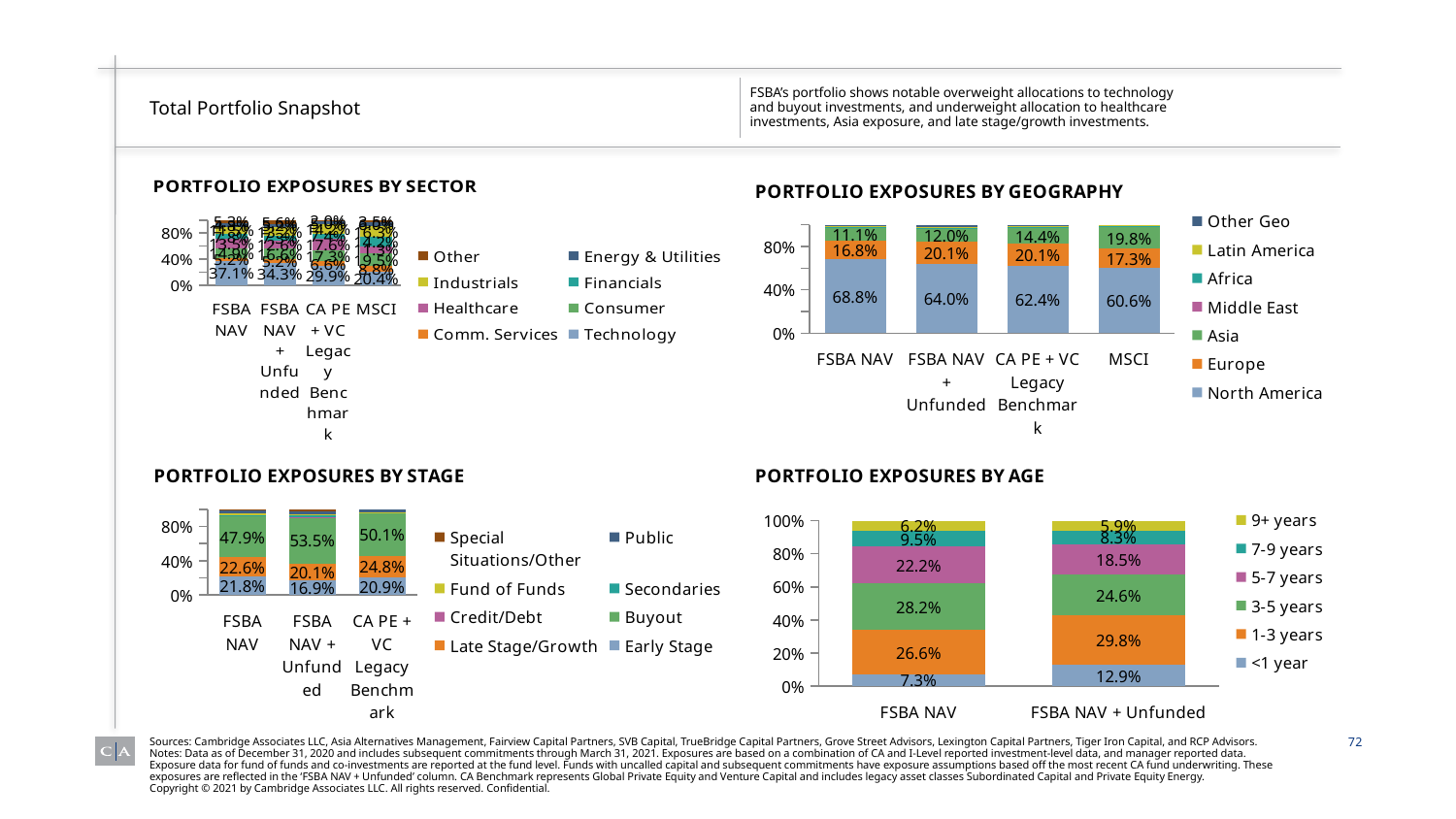
How many categories are shown on the x axis of the Portfolio Exposures by Stage chart? 3 In the Portfolio Exposures by Geography chart, which category has the highest Asia share? MSCI In the Portfolio Exposures by Stage chart, which is larger: the Early Stage share for FSBA NAV or for CA PE + VC Legacy Benchmark? FSBA NAV In the Portfolio Exposures by Stage chart, what is the Buyout share for FSBA NAV + Unfunded? 53.5% How many series does the legend of the Portfolio Exposures by Geography chart list? 7 In the Portfolio Exposures by Geography chart, what is the difference between the Europe share for FSBA NAV + Unfunded and for FSBA NAV? 3.3% In the Portfolio Exposures by Geography chart, what is the North America share for FSBA NAV? 68.8% In the Portfolio Exposures by Age chart, which age bucket has the lowest share for FSBA NAV? 9+ years In the Portfolio Exposures by Age chart, what is the 1-3 years share for FSBA NAV + Unfunded? 29.8% In the Portfolio Exposures by Sector chart, what is the Technology share for the MSCI category? 20.4% What kind of chart is the Portfolio Exposures by Age chart? Stacked bar chart In the Portfolio Exposures by Sector chart, does the Technology share rise or fall from FSBA NAV to MSCI along the x axis? fall